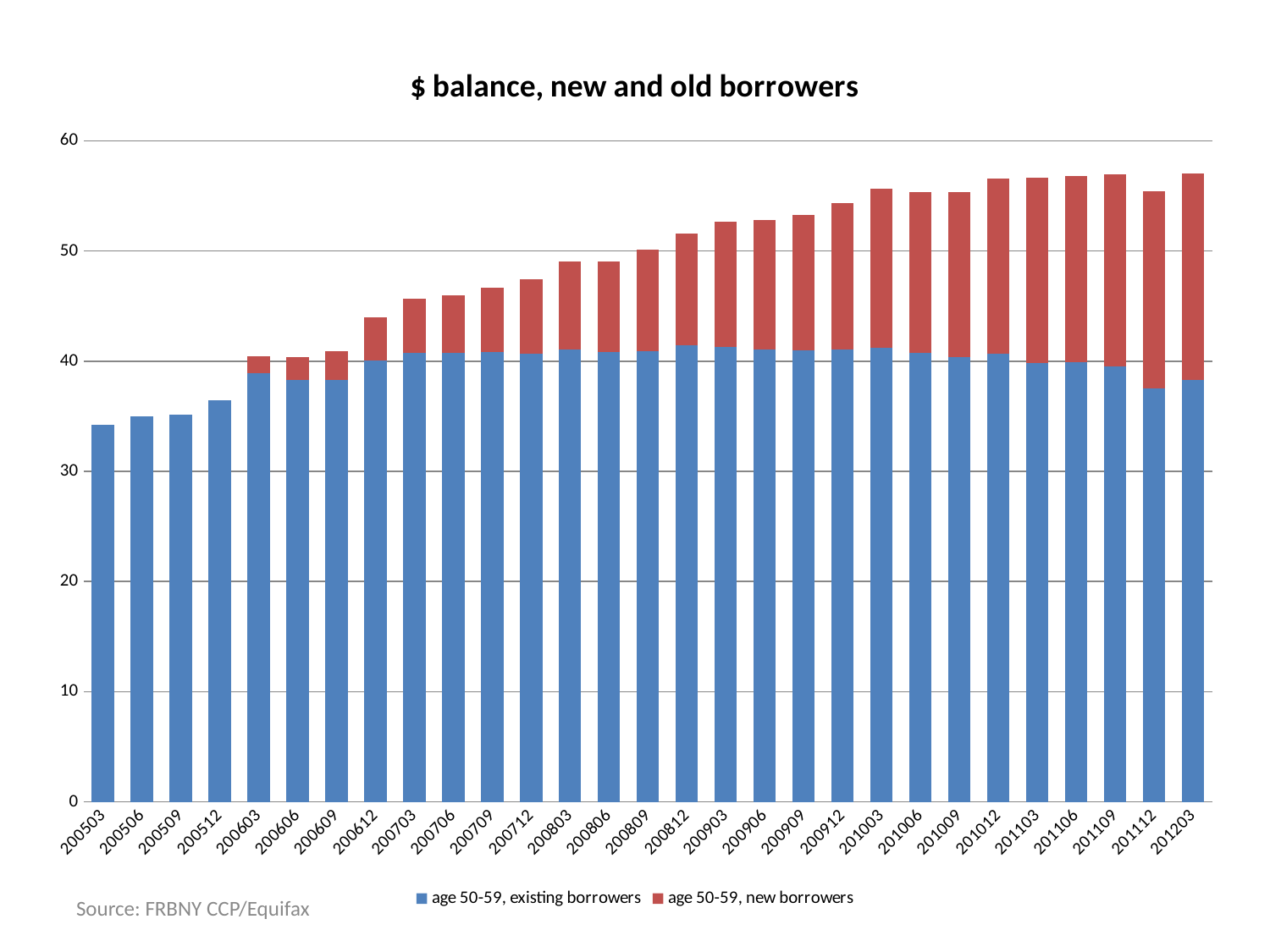
Is the total height of the stacked bar for 201203 greater or less than 50? greater Which series is shown in red? age 50-59, new borrowers Which period has the lowest total stacked bar? 200503 What is the title of the chart? $ balance, new and old borrowers Is the value for age 50-59, existing borrowers in 200503 greater or less than 40? less How many time periods are shown along the x axis? 29 Do the total stacked bar heights generally rise or fall from 200503 to 201203? rise Is the value for age 50-59, existing borrowers in 201112 greater or less than 40? less What kind of chart is shown on the slide? stacked bar chart How many series does the legend list? 2 Which is larger, the total stacked bar for 200603 or for 200612? 200612